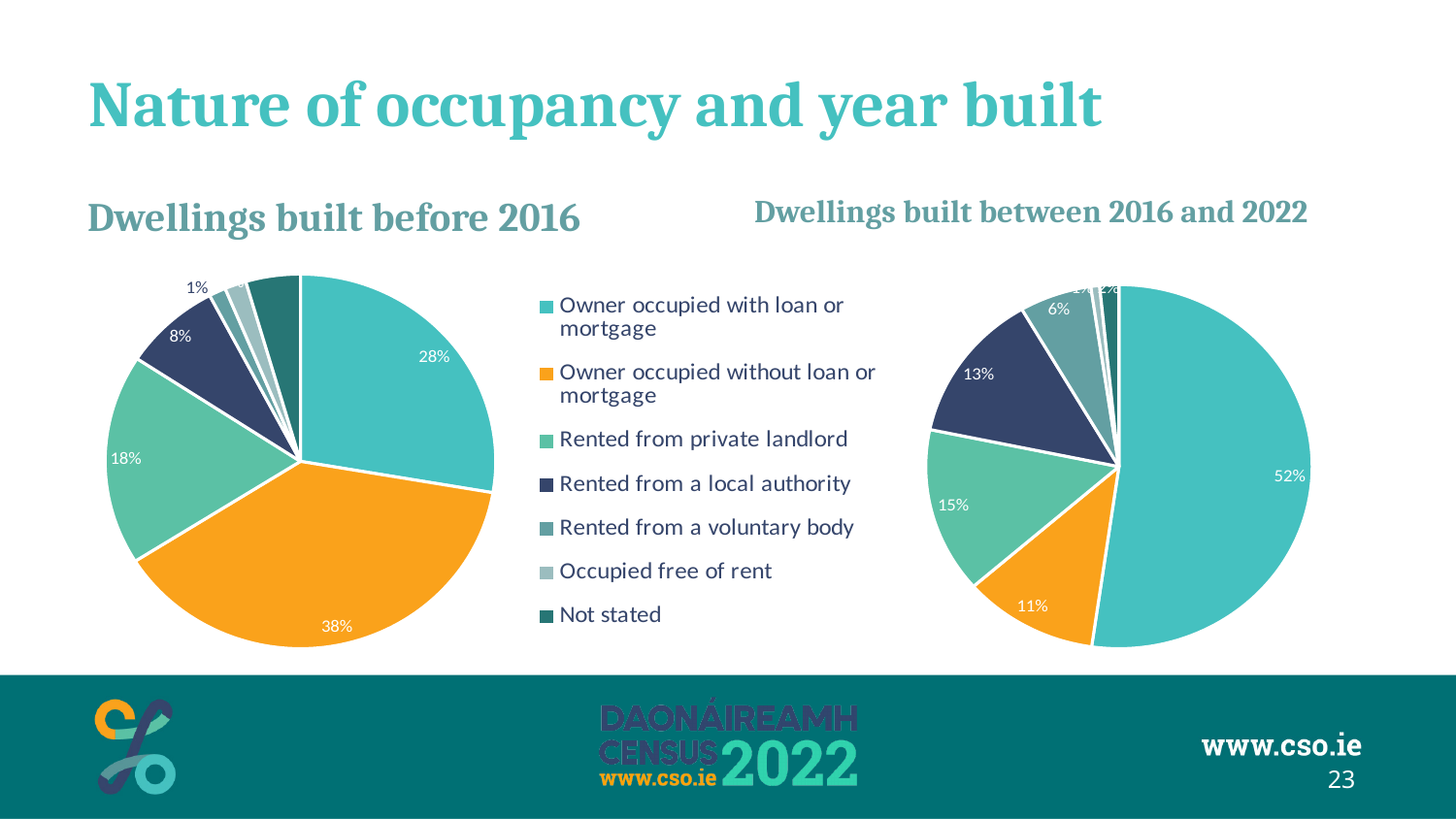
In the 'Dwellings built between 2016 and 2022' chart, what share is owner occupied with loan or mortgage? 52% In the 'Dwellings built between 2016 and 2022' chart, which category has the largest share? Owner occupied with loan or mortgage In the 'Dwellings built before 2016' chart, which category has the largest share? Owner occupied without loan or mortgage What is the difference between the owner occupied with loan or mortgage share in the 'Dwellings built between 2016 and 2022' chart and in the 'Dwellings built before 2016' chart? 24 percentage points In the 'Dwellings built before 2016' chart, what share is owner occupied with loan or mortgage? 28% In the 'Dwellings built before 2016' chart, what share is rented from a local authority? 8% In the 'Dwellings built before 2016' chart, what share is rented from private landlord? 18% In the 'Dwellings built before 2016' chart, what share is owner occupied without loan or mortgage? 38% What type of charts are shown on the slide? Pie charts How many categories does the legend list? 7 In the 'Dwellings built between 2016 and 2022' chart, what share is rented from private landlord? 15% In the 'Dwellings built between 2016 and 2022' chart, what share is rented from a voluntary body? 6%